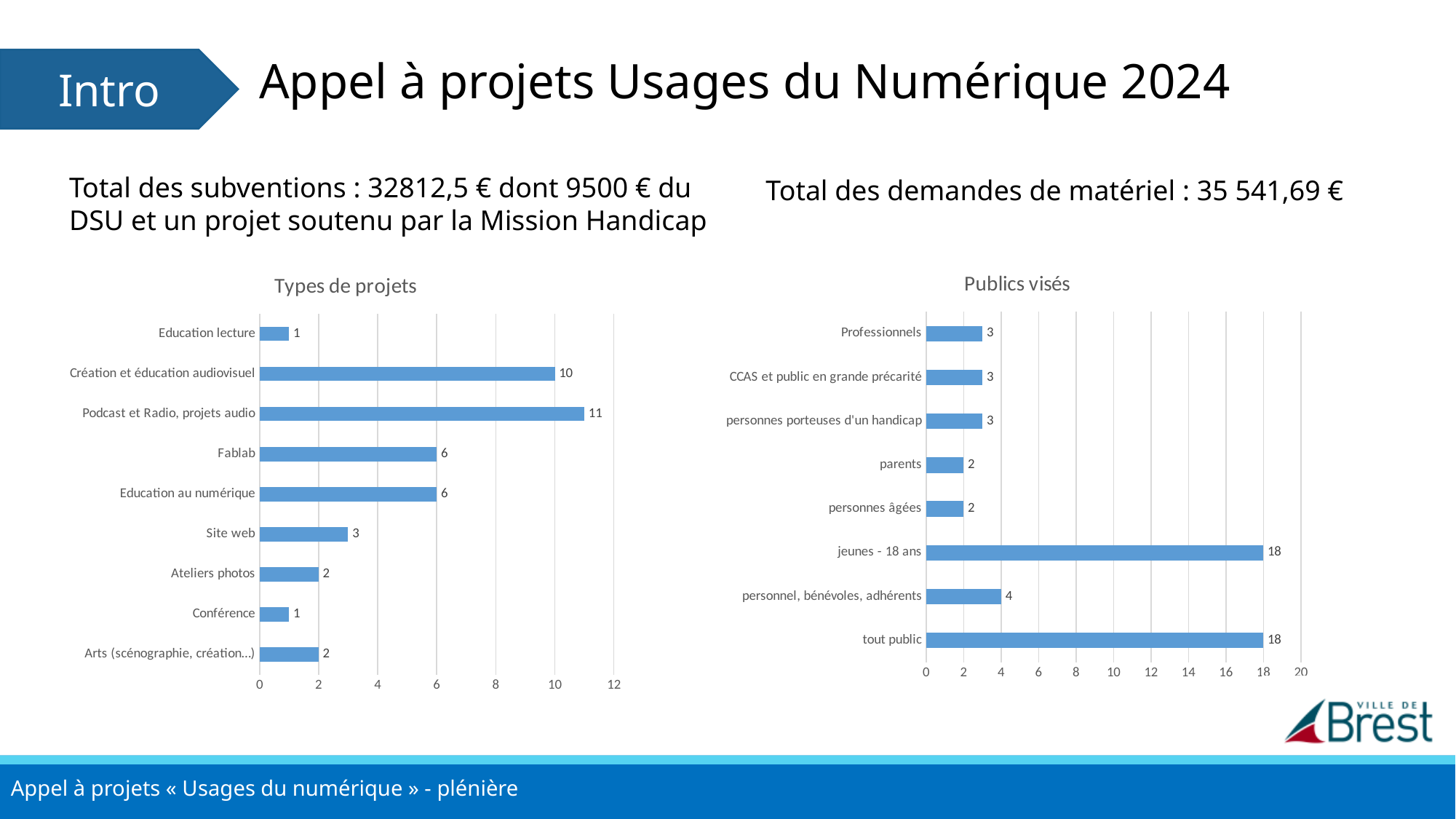
What kind of chart is the 'Publics visés' chart? Bar chart In the 'Types de projets' chart, which is larger: Ateliers photos or Site web? Site web In the 'Types de projets' chart, what is the value for Fablab? 6 In the 'Publics visés' chart, which is larger: Professionnels or personnes âgées? Professionnels In the 'Publics visés' chart, what is the value for jeunes - 18 ans? 18 In the 'Publics visés' chart, what is the value for personnel, bénévoles, adhérents? 4 In the 'Publics visés' chart, what is the difference between tout public and parents? 16 In the 'Types de projets' chart, which category has the highest value? Podcast et Radio, projets audio How many categories are shown in the 'Types de projets' chart? 9 In the 'Types de projets' chart, what is the value for Podcast et Radio, projets audio? 11 How many categories are shown in the 'Publics visés' chart? 8 In the 'Types de projets' chart, what is the difference between Création et éducation audiovisuel and Site web? 7